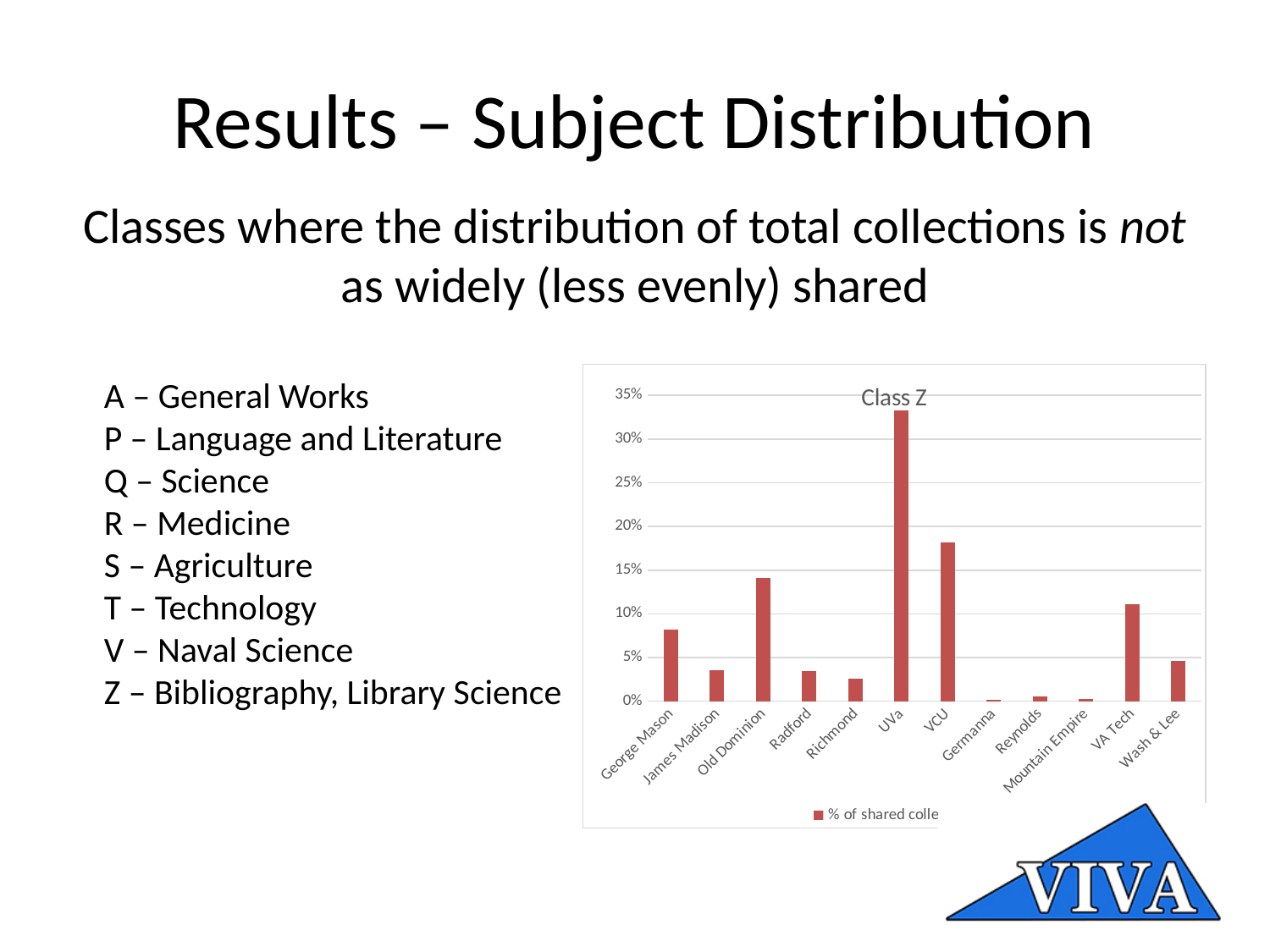
Which has the larger value, Old Dominion or VA Tech? Old Dominion What type of chart is shown on the slide? bar chart Is the value for Richmond greater or less than 5%? less Is the value for Old Dominion greater or less than 15%? less Is the value for George Mason greater or less than 5%? greater How many series does the chart's legend list? 1 Which has the larger value, UVa or VCU? UVa How many institutions (categories) are plotted on the chart? 12 Which institution has the highest value on the chart? UVa What is the title of the chart? Class Z